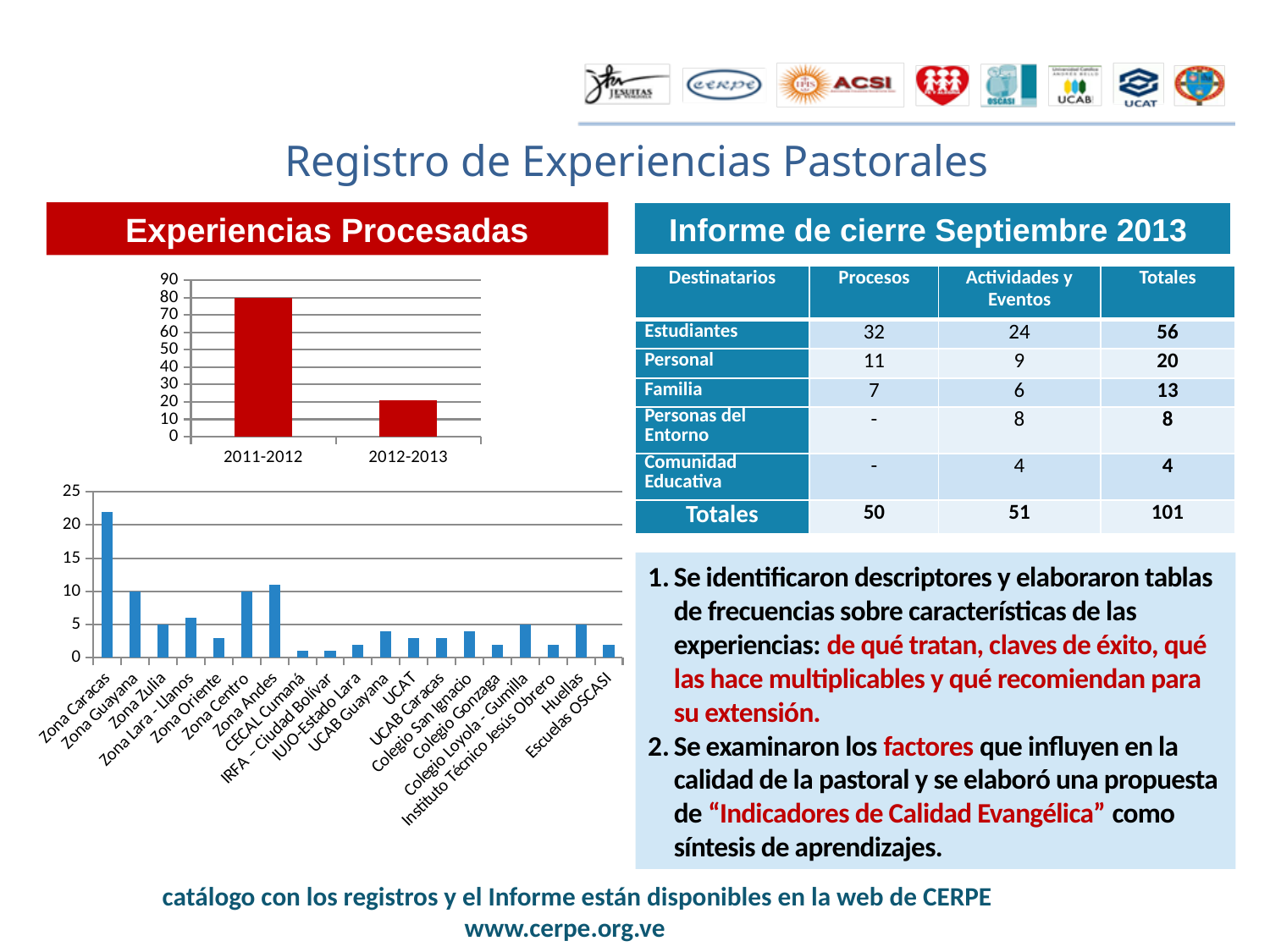
In the bottom-left chart, which category has the highest value? Zona Caracas In the top-left chart under 'Experiencias Procesadas', is the value for 2012-2013 greater or less than 30? less In the top-left chart under 'Experiencias Procesadas', how many categories are shown on the x axis? 2 In the bottom-left chart, which is larger, the value for Zona Caracas or the value for Zona Andes? Zona Caracas In the bottom-left chart, how many categories are shown on the x axis? 19 What kind of chart is the bottom-left chart with categories such as Zona Caracas and Huellas? bar chart In the top-left chart under 'Experiencias Procesadas', which period has the higher value? 2011-2012 In the top-left chart under 'Experiencias Procesadas', what is the value for 2011-2012? 80 What kind of chart is the top-left chart under 'Experiencias Procesadas'? bar chart In the top-left chart under 'Experiencias Procesadas', do the values rise or fall from 2011-2012 to 2012-2013? fall In the bottom-left chart, is the value for Zona Oriente greater or less than 5? less In the bottom-left chart, is the value for Zona Caracas greater or less than 20? greater